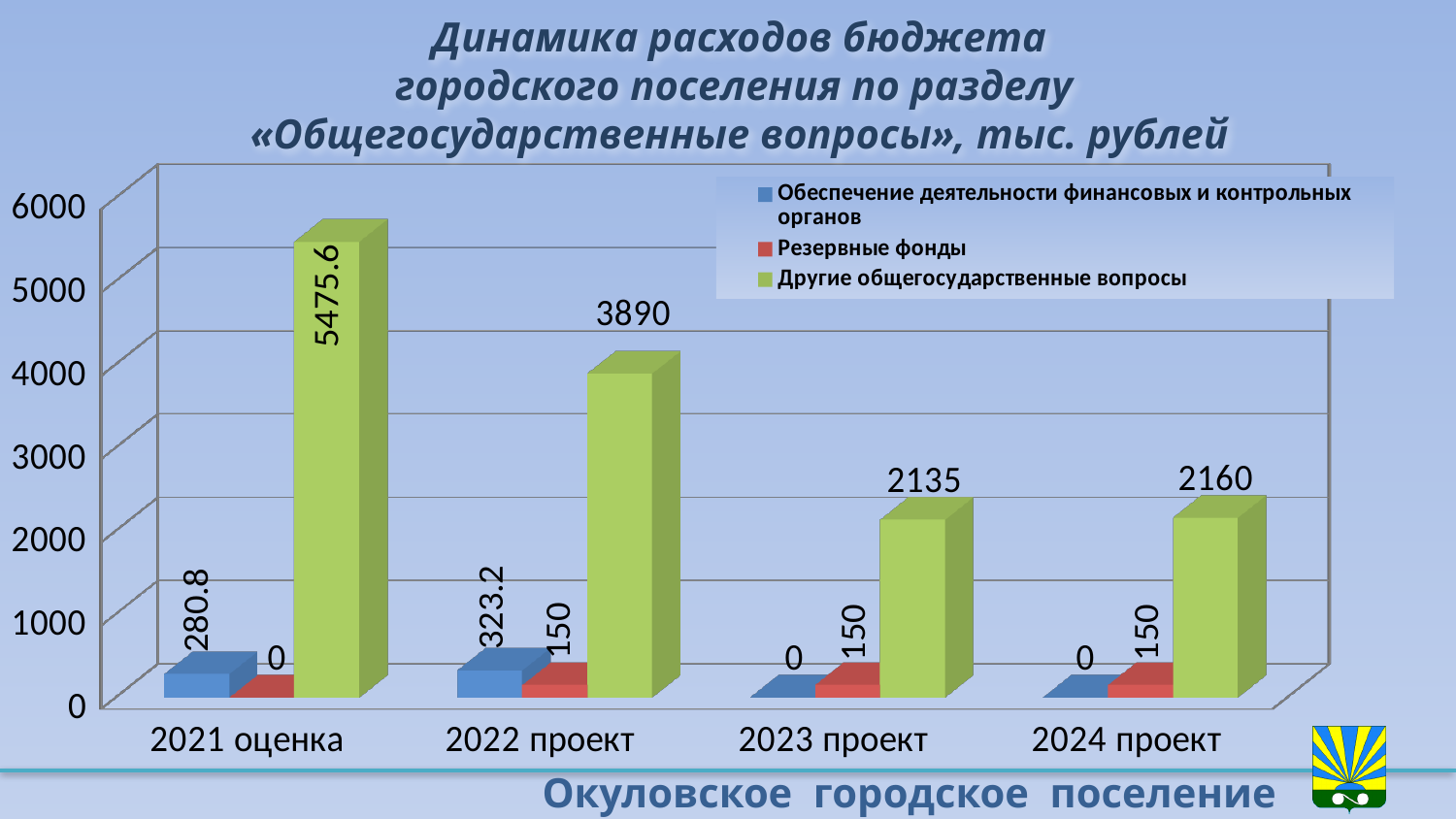
What is the value for «Обеспечение деятельности финансовых и контрольных органов» in 2022 проект? 323.2 In which year is the value for «Другие общегосударственные вопросы» the lowest? 2023 проект What is the value for «Другие общегосударственные вопросы» in 2024 проект? 2160 How many years (categories) are shown on the x axis? 4 Which is larger: the «Обеспечение деятельности финансовых и контрольных органов» value in 2021 оценка or in 2022 проект? 2022 проект In which year is the value for «Другие общегосударственные вопросы» the highest? 2021 оценка What is the difference between the «Другие общегосударственные вопросы» values for 2021 оценка and 2022 проект? 1585.6 What is the value for «Другие общегосударственные вопросы» in 2021 оценка? 5475.6 What is the value for «Резервные фонды» in 2023 проект? 150 What kind of chart is shown on the slide? bar chart Is the value for «Другие общегосударственные вопросы» in 2022 проект greater or less than 4000? less How many series does the legend list? 3